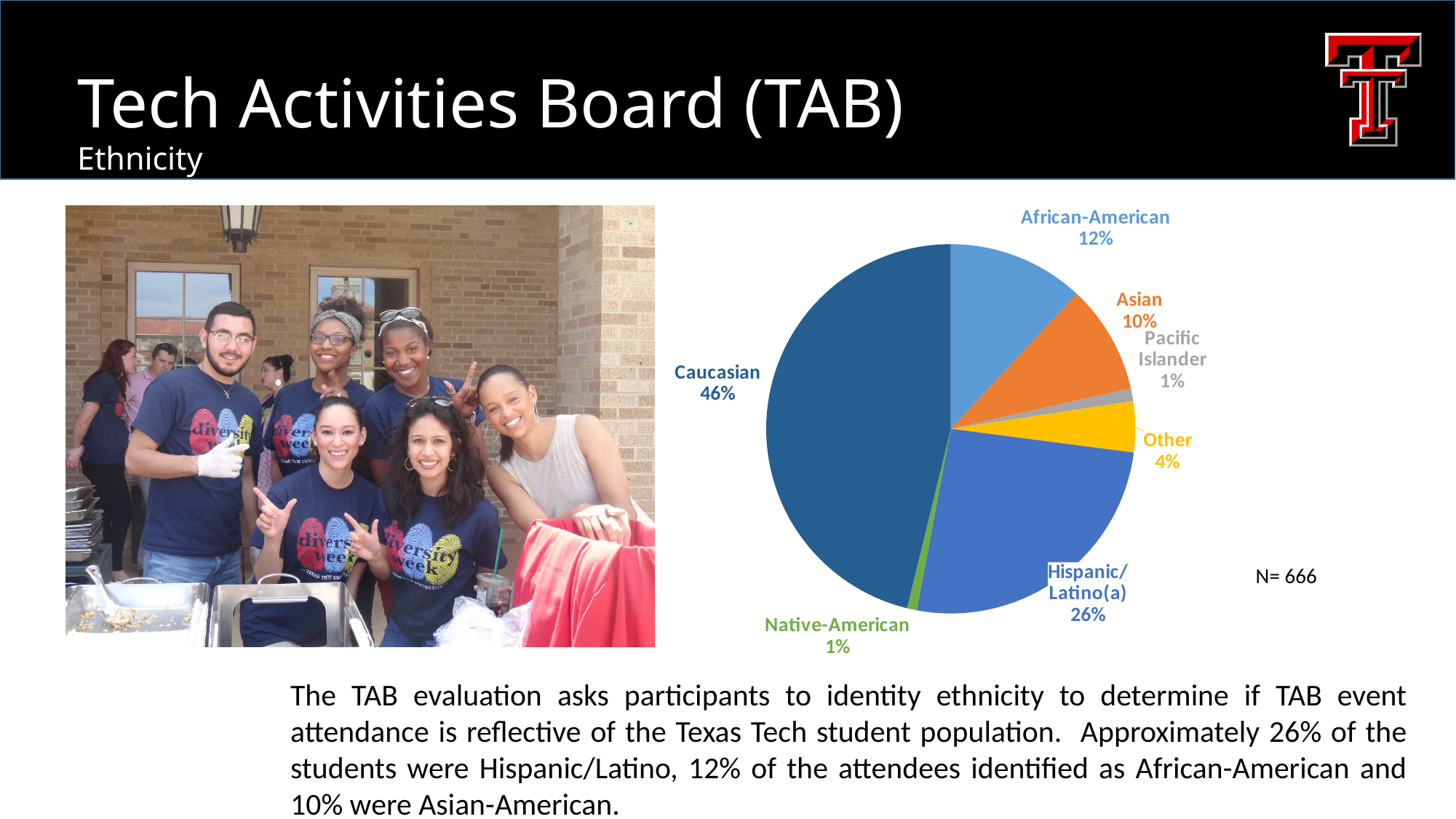
What share of the pie is Hispanic/Latino(a)? 26% What percentage of TAB event attendees identified as Caucasian? 46% What type of chart is shown on the slide? pie chart What percentage of attendees identified as Native-American? 1% What is the difference in percentage points between the Caucasian and Hispanic/Latino(a) slices? 20 What percentage of attendees identified as African-American? 12% How many ethnicity categories are shown in the pie chart? 7 What is the sample size (N) shown next to the pie chart? N= 666 What percentage is shown for the Other category? 4% Which is larger, the African-American slice or the Asian slice? African-American Which ethnicity category has the largest slice of the pie? Caucasian What percentage of attendees identified as Asian? 10%